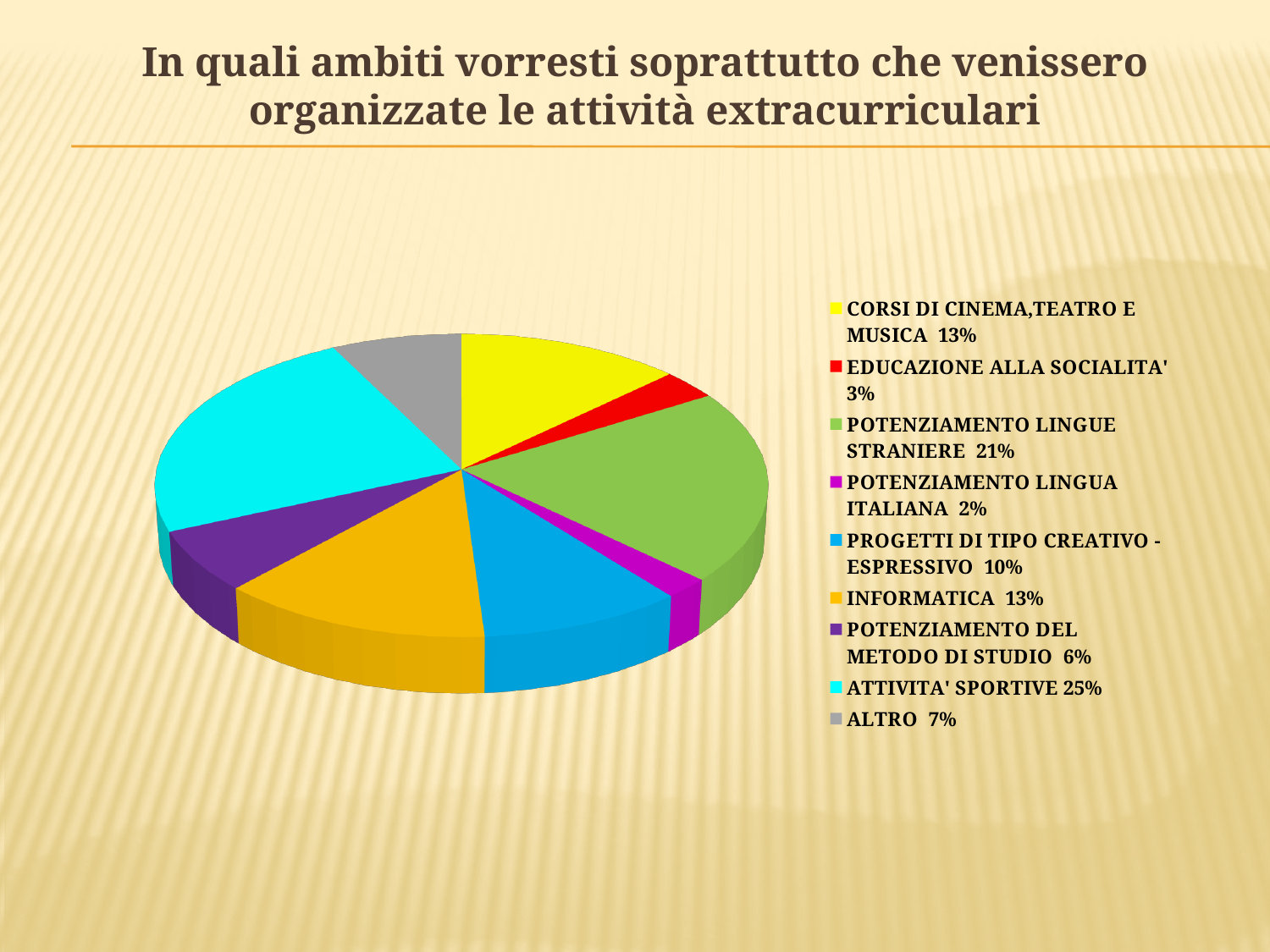
What is the value for INFORMATICA? 13% What is the difference between the shares of ATTIVITA' SPORTIVE and POTENZIAMENTO LINGUE STRANIERE? 4% Which is larger, the share for PROGETTI DI TIPO CREATIVO - ESPRESSIVO or the share for ALTRO? PROGETTI DI TIPO CREATIVO - ESPRESSIVO How many categories does the pie chart have? 9 Which category has the largest share of the pie? ATTIVITA' SPORTIVE What is the value for POTENZIAMENTO DEL METODO DI STUDIO? 6% What is the value for POTENZIAMENTO LINGUE STRANIERE? 21% What kind of chart is shown on the slide? Pie chart What colour is the slice for ATTIVITA' SPORTIVE? Cyan What share of the pie does ATTIVITA' SPORTIVE have? 25% What is the value for EDUCAZIONE ALLA SOCIALITA'? 3% Which category has the smallest share of the pie? POTENZIAMENTO LINGUA ITALIANA